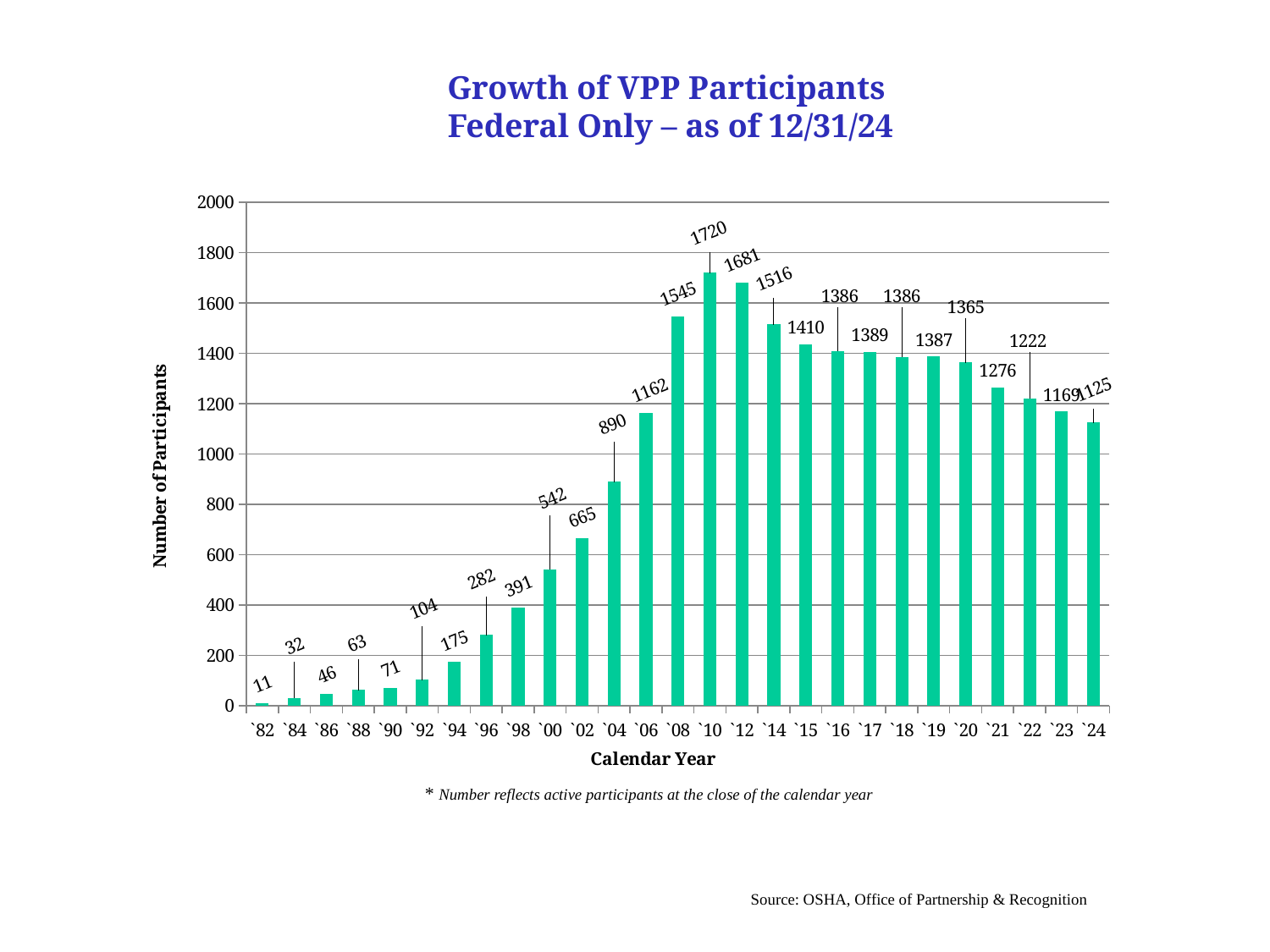
Which calendar year has the lowest number of participants? `82 What kind of chart is shown on the slide? bar chart What is the difference in participants between `08 and `06? 383 What is the number of participants for `04? 890 Is the value for `22 greater or less than 1400? less Which calendar year has the highest number of participants? `10 How many calendar years are shown on the x axis? 27 What is the number of participants for `24? 1125 Do the values rise or fall from `82 to `10? rise Which has more participants, `14 or `15? `14 What is the difference in participants between `10 and `12? 39 What is the number of participants for `10? 1720